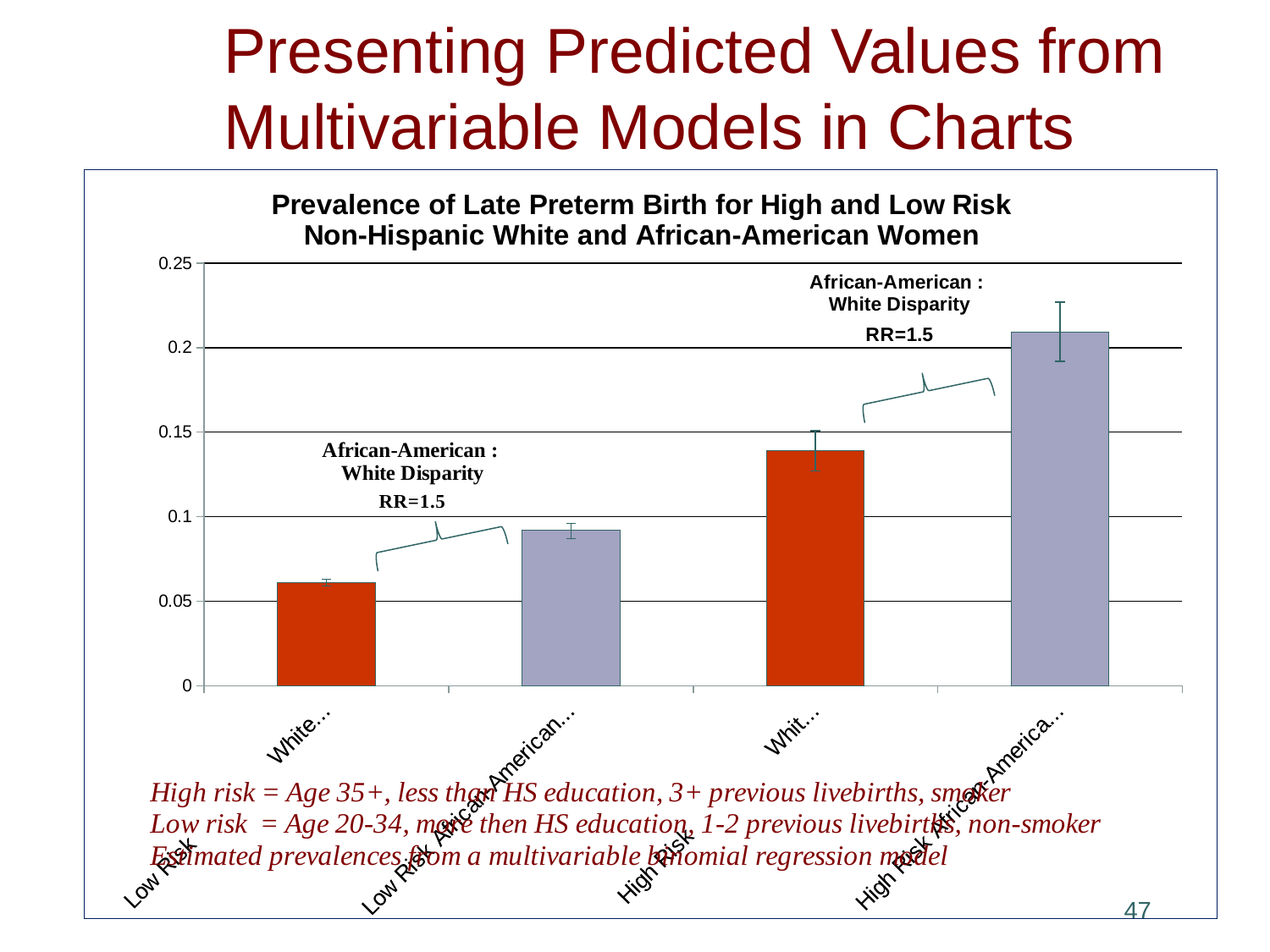
Do the bar values rise or fall from left to right across the categories? Rise Is the value for High Risk White greater or less than 0.1? greater What is the title of the chart? Prevalence of Late Preterm Birth for High and Low Risk Non-Hispanic White and African-American Women Which is larger, the value for High Risk White or the value for Low Risk African-American? High Risk White Which is larger, the value for Low Risk White or the value for Low Risk African-American? Low Risk African-American Is the value for High Risk African-American greater or less than 0.15? greater How many bars are plotted in the chart? 4 What kind of chart is shown on the slide? Bar chart What relative risk (RR) is annotated for the African-American : White disparity in the chart? RR=1.5 Which category has the highest prevalence of late preterm birth? High Risk African-American Is the value for Low Risk White greater or less than 0.1? less Which category has the lowest prevalence of late preterm birth? Low Risk White